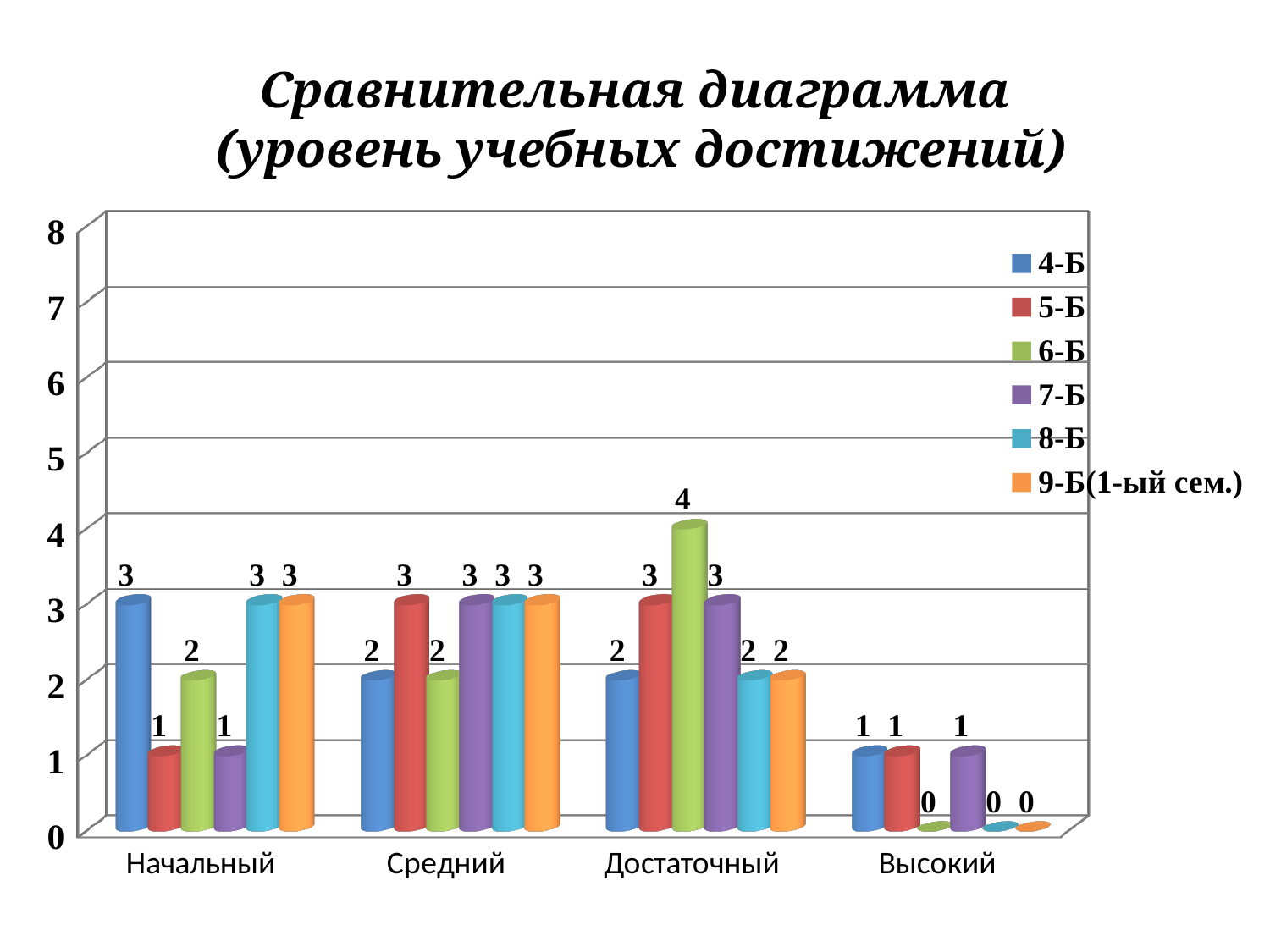
Is the value for 4-Б in the Начальный category larger than the value for 7-Б in the same category? Yes Which series has the lowest value in the Средний category, 4-Б or 5-Б? 4-Б How many categories are shown on the x axis? 4 What is the value for 5-Б in the Начальный category? 1 How many series does the legend list? 6 What is the last entry in the legend? 9-Б(1-ый сем.) What is the difference between the 6-Б value and the 4-Б value in the Достаточный category? 2 What is the difference between the 6-Б value in the Начальный category and the 6-Б value in the Высокий category? 2 What kind of chart is shown on the slide? Bar chart What is the value for 8-Б in the Высокий category? 0 Which series has the highest value in the Достаточный category? 6-Б What is the value for 6-Б in the Достаточный category? 4